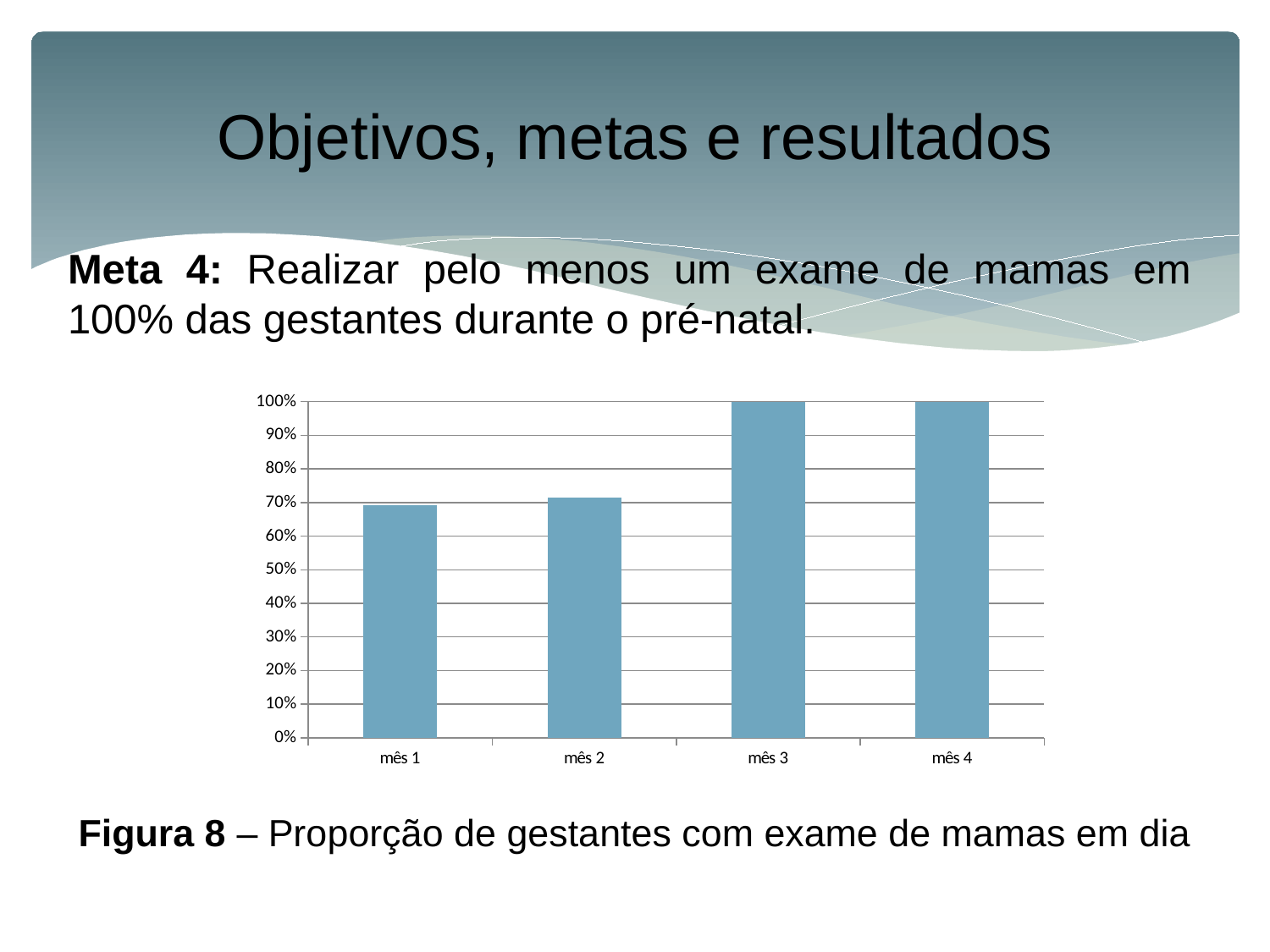
Which has the larger value, mês 2 or mês 4? mês 4 Is the value for mês 1 greater or less than 80%? less Is the value for mês 2 greater or less than 80%? less What is the value for mês 3 in the chart? 100% What is the value for mês 4 in the chart? 100% What kind of chart is shown on the slide? bar chart Is the value for mês 2 greater or less than 60%? greater Which has the larger value, mês 1 or mês 3? mês 3 Do the values in the chart generally rise or fall from mês 1 to mês 4? rise How many categories (months) are shown on the x axis of the chart? 4 What is the figure number given in the caption below the chart? Figura 8